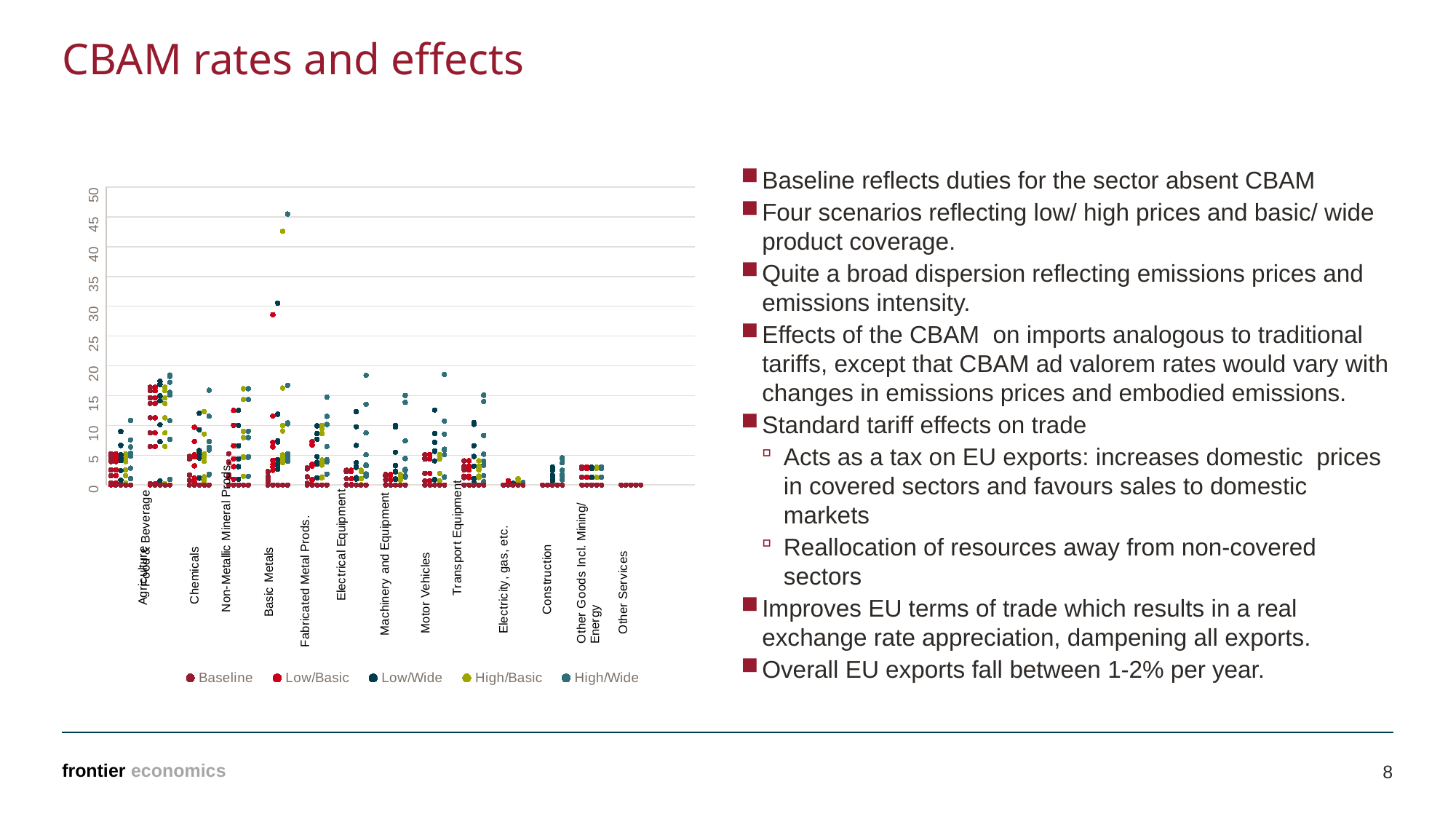
Which series are listed in the chart legend? Baseline, Low/Basic, Low/Wide, High/Basic, High/Wide What kind of chart is shown on the slide? scatter (dot) chart Is the highest plotted value for Chemicals greater or less than 25? less Which has the higher maximum plotted value: Basic Metals or Construction? Basic Metals Is the highest plotted value for Construction greater or less than 10? less How many series does the chart legend list? 5 Is the highest plotted value for Basic Metals greater or less than 40? greater Which sector contains the highest plotted value in the chart? Basic Metals What is the maximum value shown on the chart's vertical axis? 50 Which series has the highest point in the Basic Metals category? High/Wide How many sector categories are shown along the x axis of the chart? 14